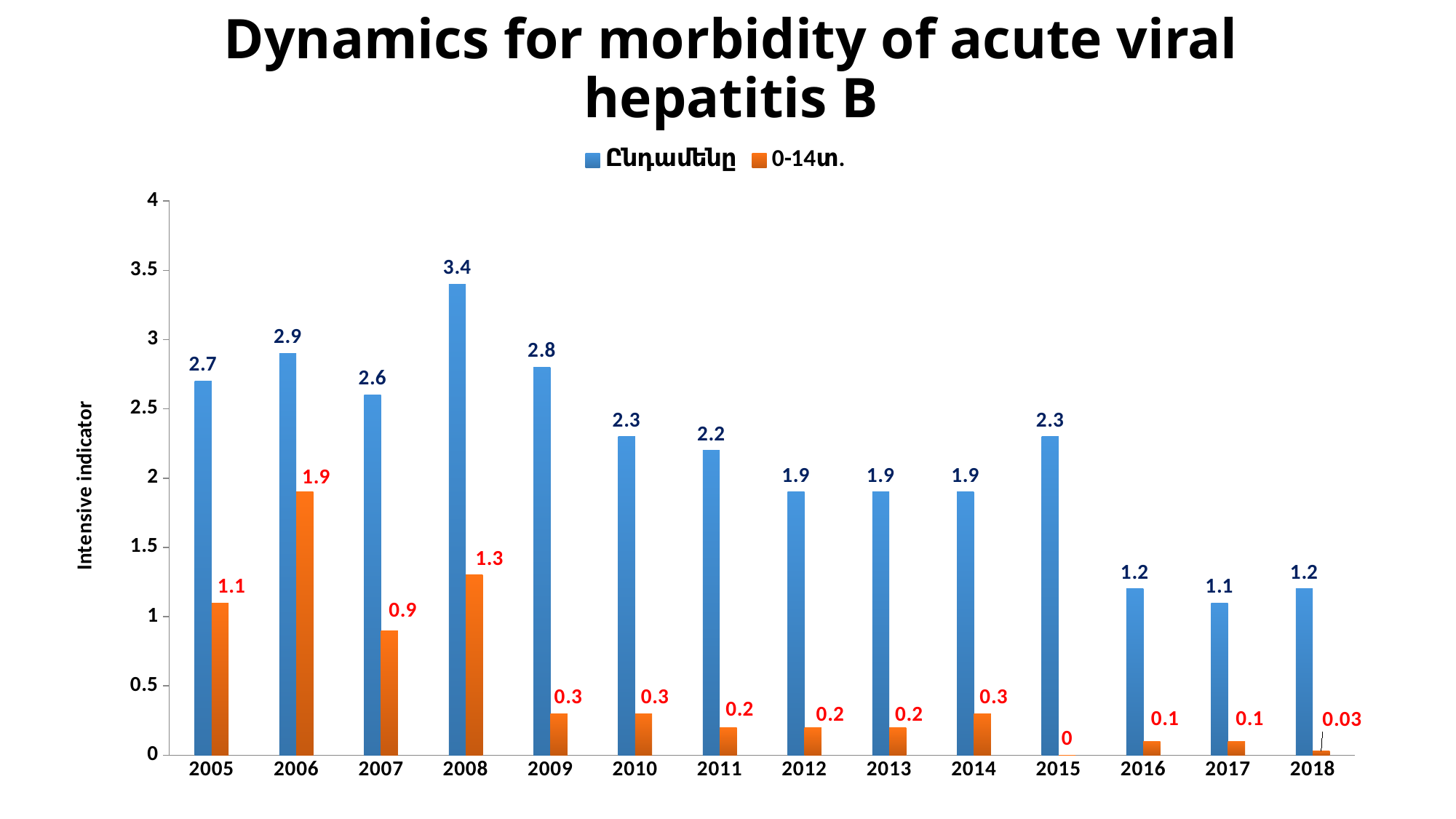
In which year is the Ընդամենը (blue) series highest? 2008 What is the value of the 0-14տ. (orange) series for 2018? 0.03 What is the value of the 0-14տ. (orange) series for 2006? 1.9 What is the value of the Ընդամենը (blue) series for 2008? 3.4 What is the title of the chart? Dynamics for morbidity of acute viral hepatitis B In which year is the 0-14տ. (orange) series lowest? 2015 How many series does the legend list? 2 How many years are shown on the x axis? 14 Does the Ընդամենը (blue) series generally rise or fall from 2008 to 2018? fall What is the difference between the Ընդամենը value for 2008 and the Ընդամենը value for 2009? 0.6 What type of chart is shown on the slide? bar chart Which is larger: the Ընդամենը value for 2015 or the Ընդամենը value for 2016? 2015